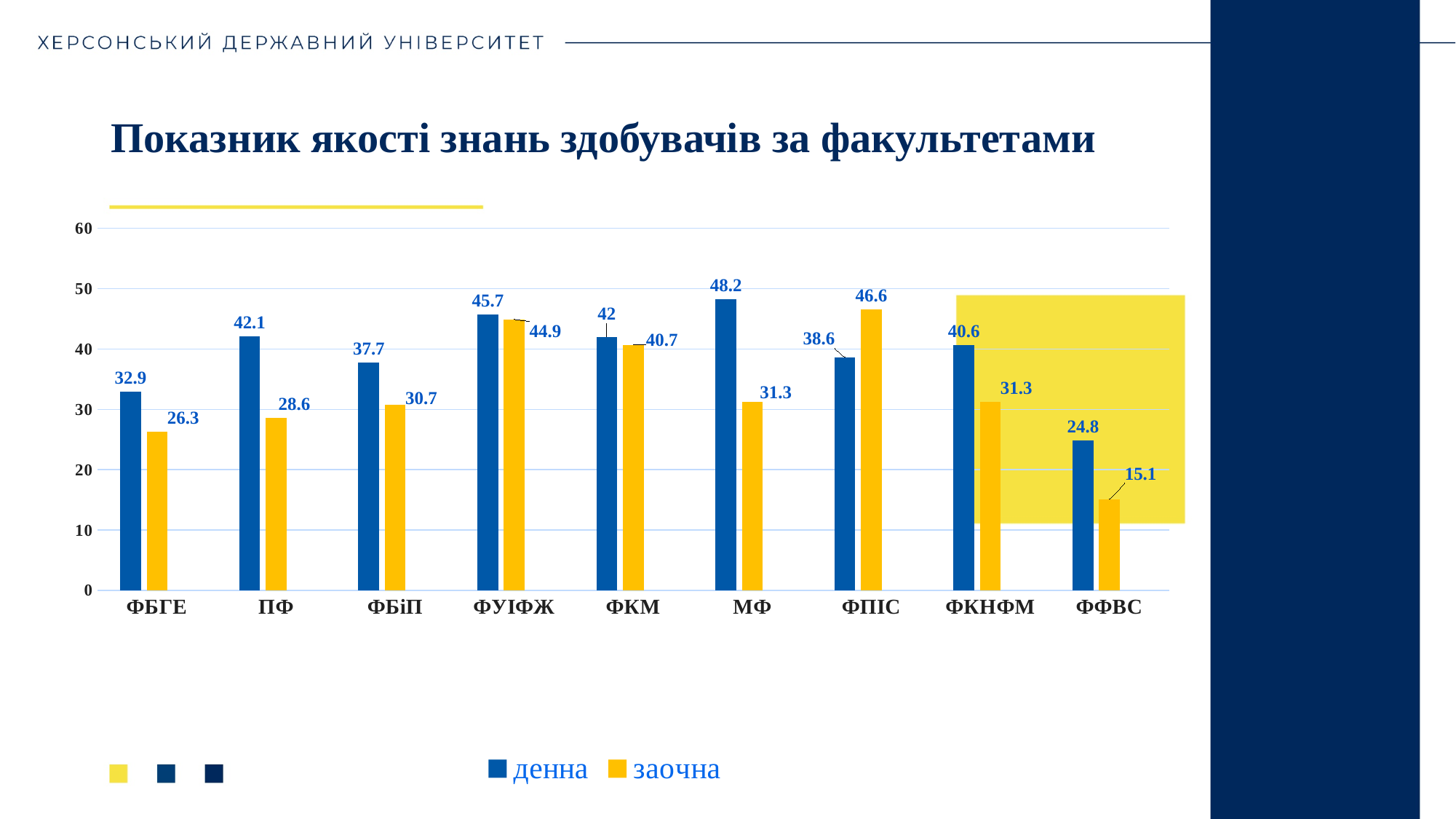
What kind of chart is shown on the slide? bar chart Which faculty has the highest денна value? МФ What is the заочна value for ФФВС? 15.1 What is the title of the chart? Показник якості знань здобувачів за факультетами How many series does the legend list? 2 Which faculty has the lowest заочна value? ФФВС How many faculties are shown on the x axis? 9 Which is larger for ФПІС, the денна value or the заочна value? заочна What is the заочна value for ФПІС? 46.6 What is the difference between the денна and заочна values for ФБГЕ? 6.6 Is the денна value for ФФВС greater or less than 30? less What is the денна value for МФ? 48.2